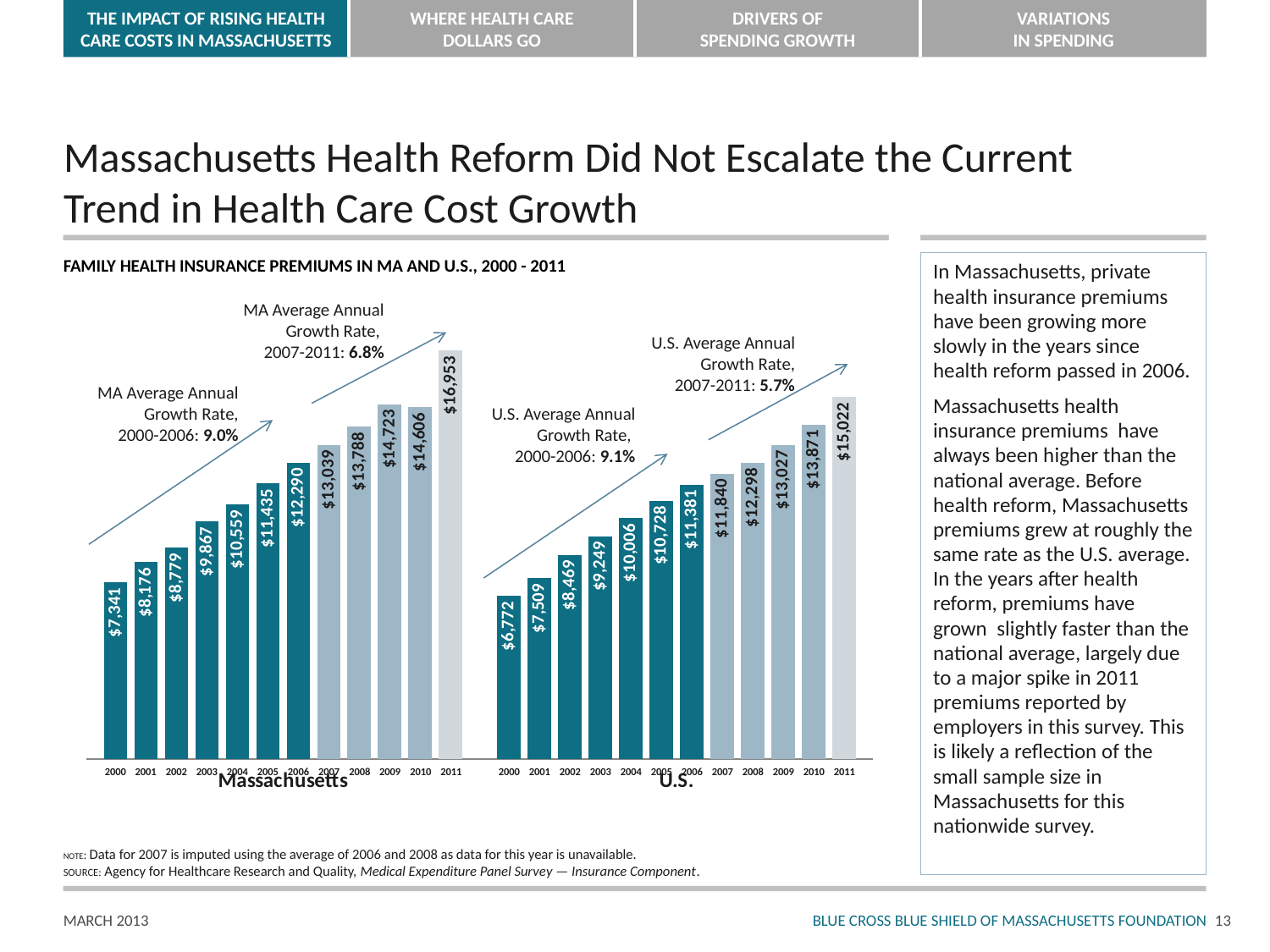
What was the MA average annual growth rate for 2007-2011? 6.8% What was the U.S. family health insurance premium in 2011? $15,022 What was the Massachusetts family health insurance premium in 2006? $12,290 Which year has the highest Massachusetts premium? 2011 How much higher was the Massachusetts premium than the U.S. premium in 2011? $1,931 How many years are shown for the Massachusetts group? 12 Do U.S. premiums generally rise or fall from 2000 to 2011? Rise What kind of chart is used to show the premiums? Bar chart Which was larger in 2010: the Massachusetts premium or the U.S. premium? Massachusetts Which year has the lowest U.S. premium? 2000 What was the family health insurance premium in Massachusetts in 2000? $7,341 What was the U.S. average annual growth rate for 2000-2006? 9.1%